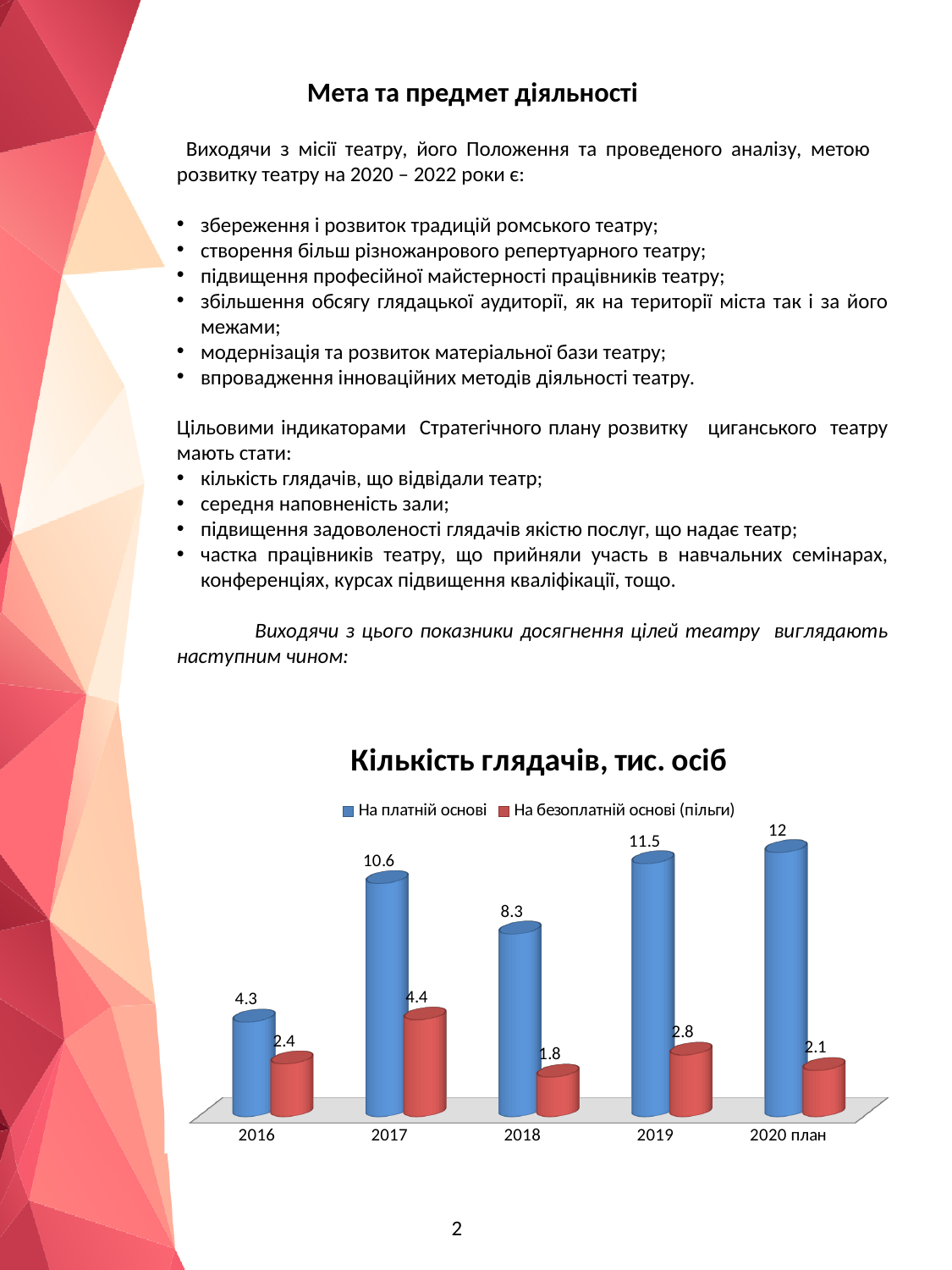
What is the difference between the 'На платній основі' values for 2019 and 2018? 3.2 Which year has the highest value for 'На платній основі'? 2020 план Does the 'На платній основі' series rise or fall from 2018 to 2020 план? Rise Which colour represents 'На безоплатній основі (пільги)' in the chart? Red What is the value for 'На безоплатній основі (пільги)' in 2019? 2.8 How many series does the legend list? 2 What kind of chart is shown? Bar chart How many years (categories) are shown on the x axis? 5 Which year has the lowest value for 'На безоплатній основі (пільги)'? 2018 What is the title of the chart? Кількість глядачів, тис. осіб What is the value for 'На платній основі' in 2017? 10.6 Which is larger: 'На безоплатній основі (пільги)' in 2017 or in 2020 план? 2017